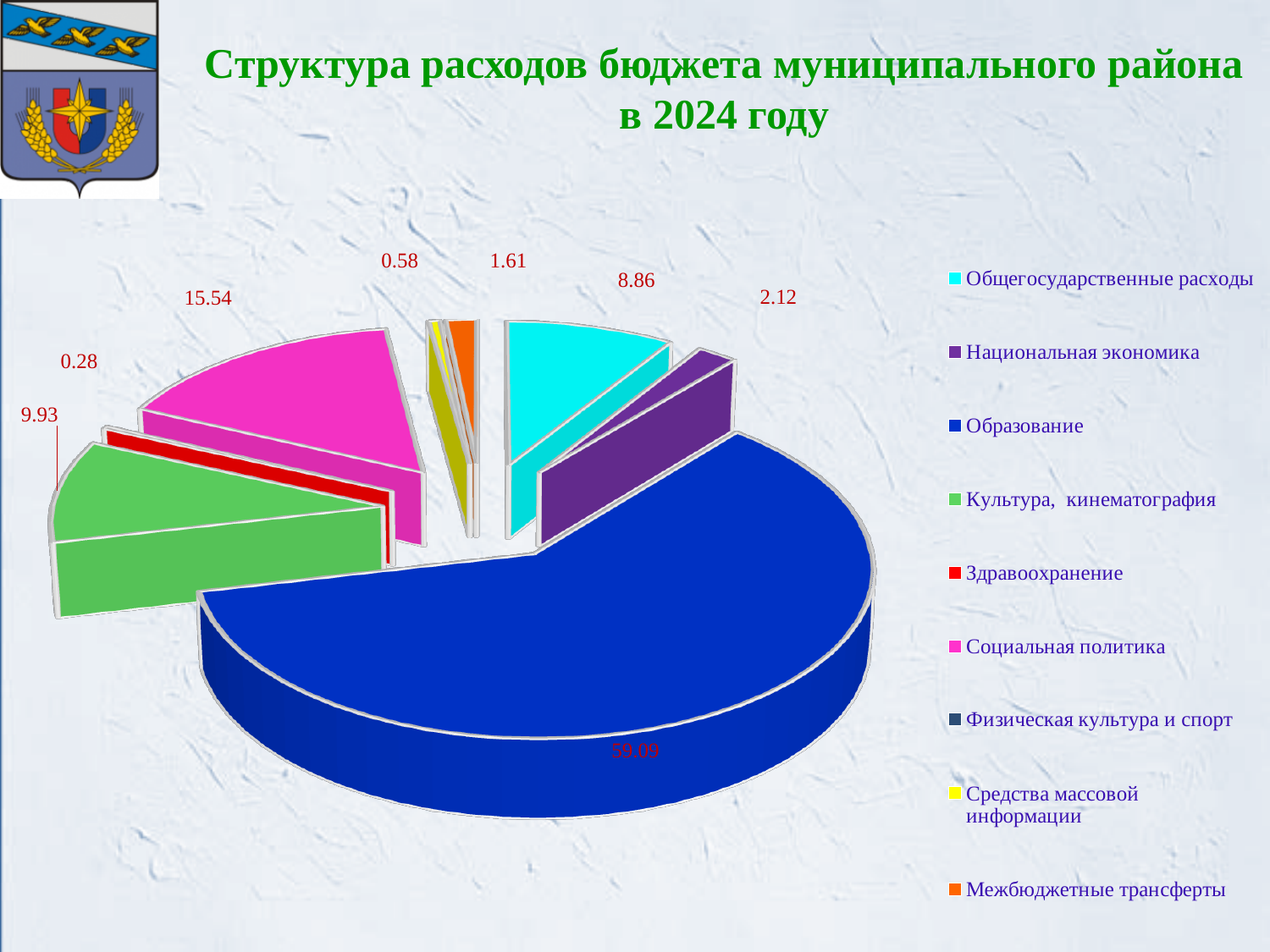
What value is shown for Культура, кинематография? 9.93 What value is shown for Социальная политика? 15.54 Which is larger, Социальная политика or Культура, кинематография? Социальная политика What is the title of the chart on the slide? Структура расходов бюджета муниципального района в 2024 году What value is shown for Национальная экономика? 2.12 What value is shown for Здравоохранение? 0.28 What value is shown for Общегосударственные расходы? 8.86 What value is shown for Образование? 59.09 What is the difference between the values for Социальная политика and Культура, кинематография? 5.61 How many categories does the legend list? 9 What kind of chart is shown on the slide? pie chart Which category has the largest slice of the pie? Образование